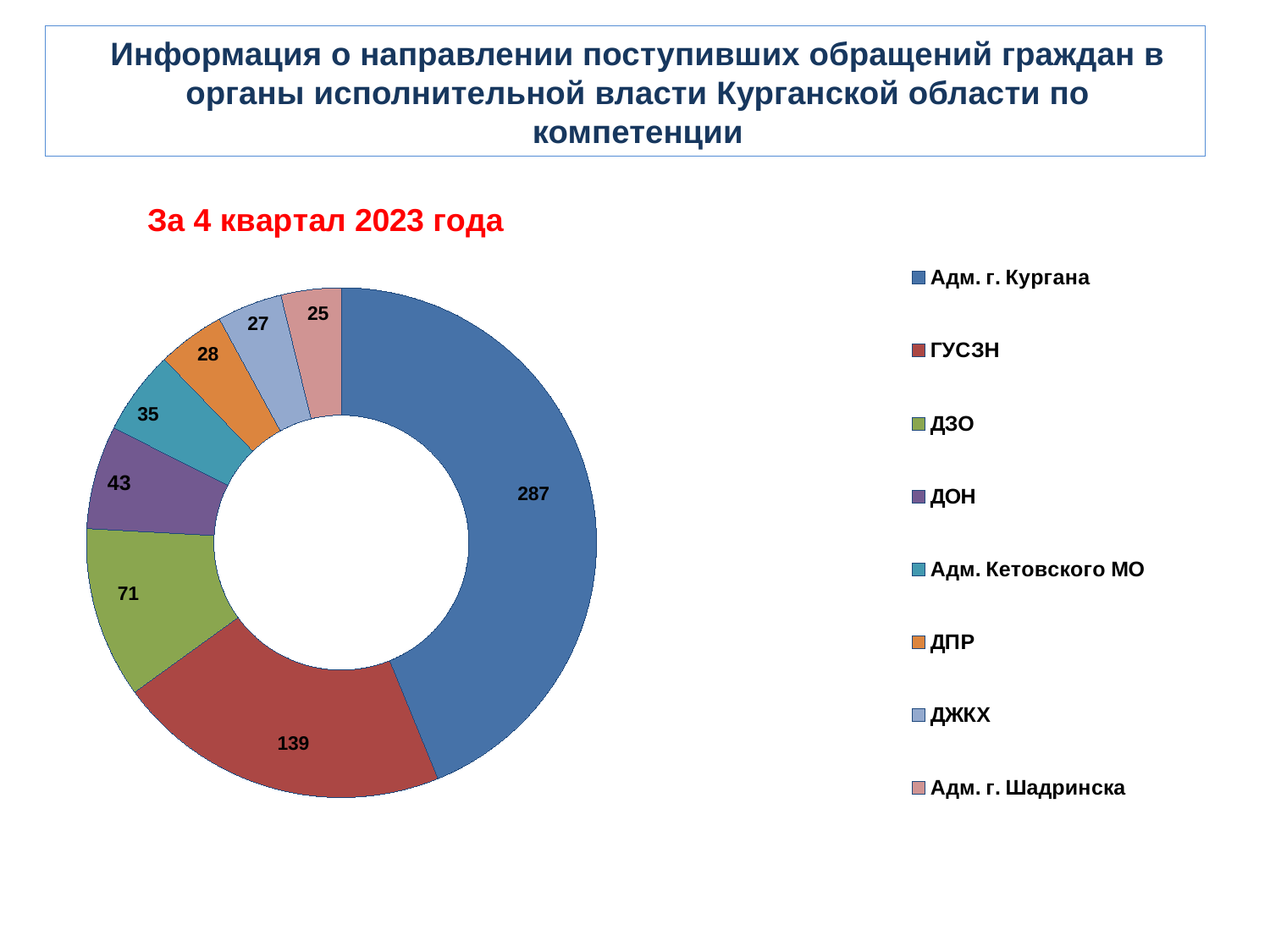
What period does the chart cover, according to the red subtitle? За 4 квартал 2023 года How many categories are shown in the chart? 8 What is the difference between the values for Адм. г. Кургана and ГУСЗН? 148 What is the difference between the values for ДЗО and ДОН? 28 What kind of chart is shown on the slide? doughnut chart What value is shown for ГУСЗН? 139 What value is shown for ДОН? 43 What value is shown for Адм. г. Кургана? 287 Which category has the smallest value? Адм. г. Шадринска What value is shown for Адм. г. Шадринска? 25 Which category has the largest value? Адм. г. Кургана Which is larger, the value for Адм. Кетовского МО or the value for ДПР? Адм. Кетовского МО